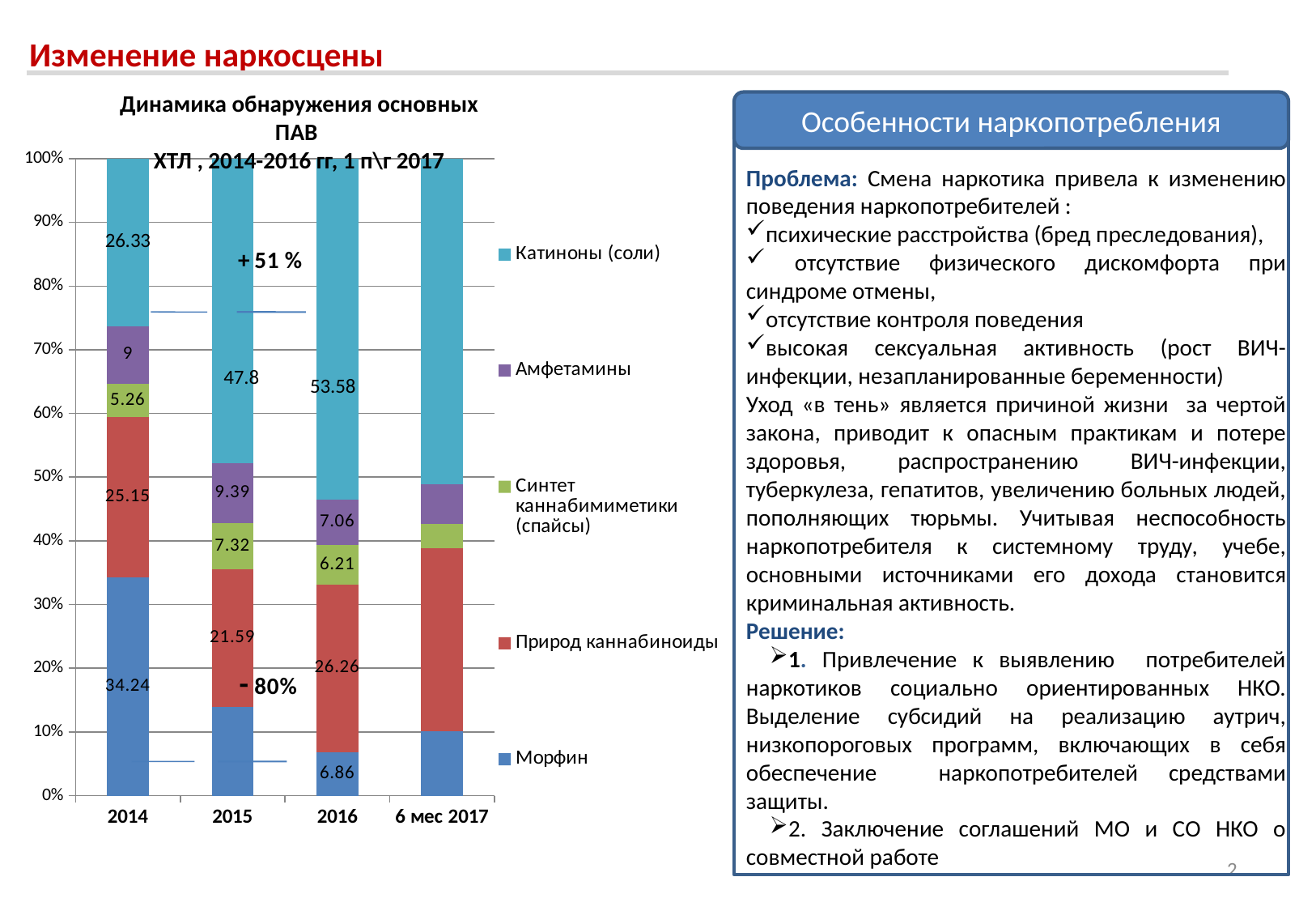
How many series does the legend list? 5 What is the value for Природ каннабиноиды in 2016? 26.26 In which year is the Морфин value lowest? 2016 In which year is the Катиноны (соли) value highest? 2016 What is the value for Катиноны (соли) in 2015? 47.8 What is the value for Синтет каннабимиметики (спайсы) in 2015? 7.32 How many categories are shown on the x axis? 4 Which is larger, the Морфин value for 2014 or for 2016? 2014 What is the difference between the Катиноны (соли) values for 2016 and 2014? 27.25 Is the Морфин share in 2015 greater or less than 10%? greater What kind of chart is shown on the slide? Stacked bar chart What is the value for Морфин in 2014? 34.24